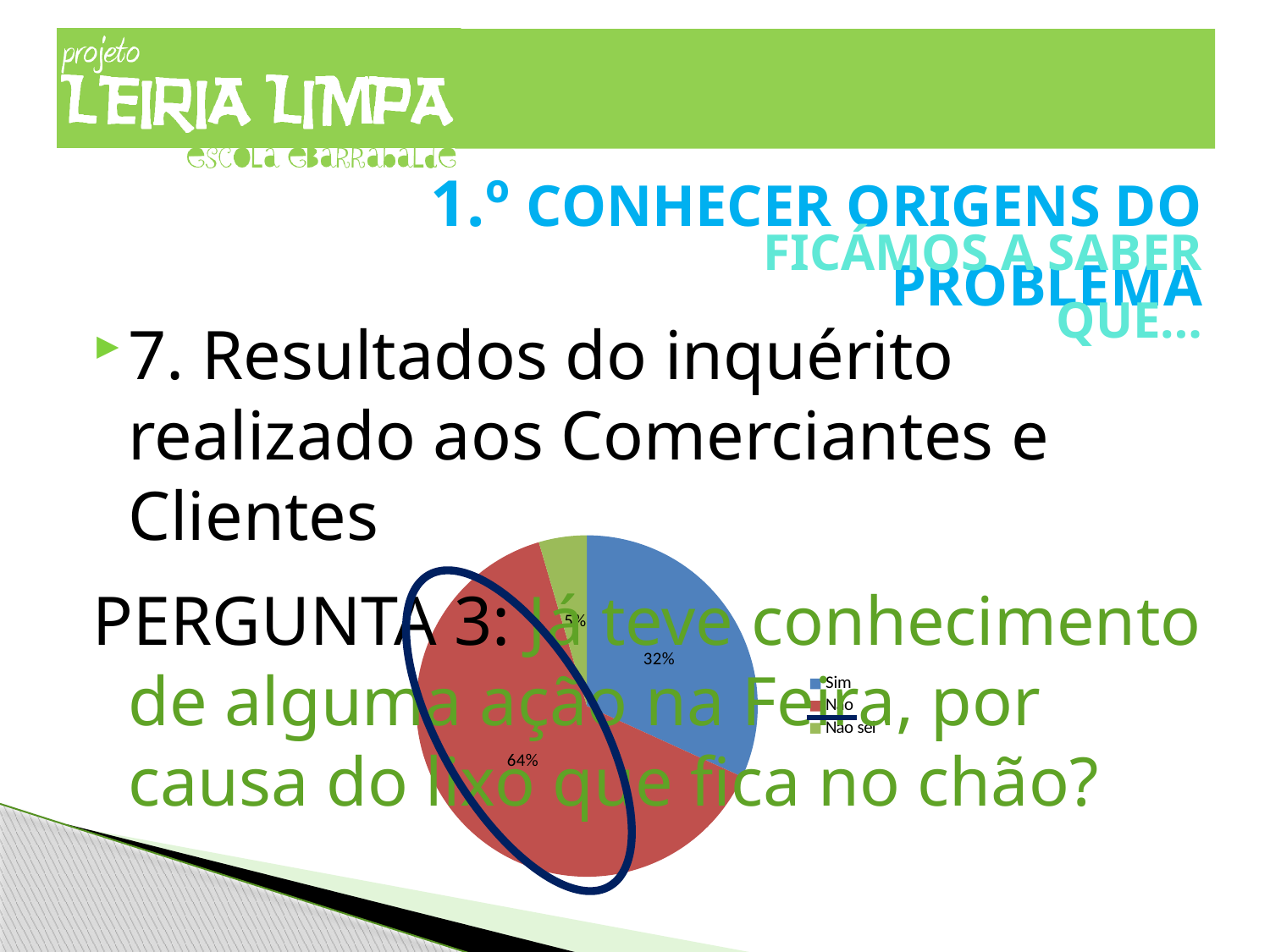
How many entries does the legend of the pie chart list? 3 What percentage of the pie chart is the "Não" slice? 64% What colour is the "Sim" slice in the pie chart? blue Which category has the smallest slice in the pie chart? Não sei How many slices does the pie chart have? 3 What is the difference in percentage points between the "Não" slice and the "Sim" slice? 32 What percentage of the pie chart is the "Sim" slice? 32% Which category has the largest slice in the pie chart? Não What kind of chart is shown on the slide? pie chart What colour is the "Não" slice in the pie chart? red Which slice is larger, "Sim" or "Não sei"? Sim What percentage of the pie chart is the "Não sei" slice? 5%